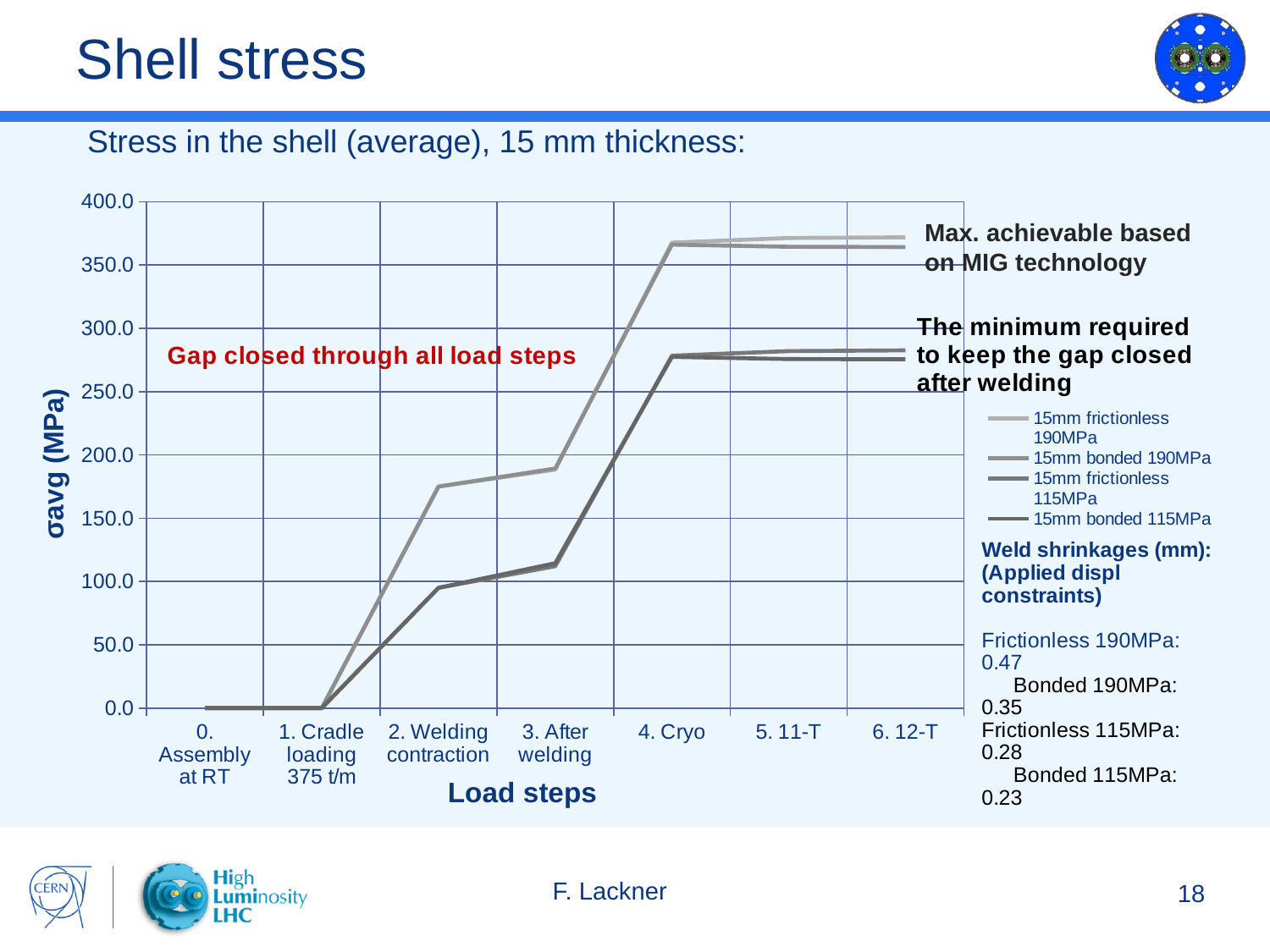
How many series does the legend list? 4 At "4. Cryo", which is larger: the 15mm bonded 190MPa series or the 15mm bonded 115MPa series? 15mm bonded 190MPa Do the series values generally rise or fall from "0. Assembly at RT" to "4. Cryo"? rise Is the value of the 15mm frictionless 190MPa series at "2. Welding contraction" greater or less than 150? greater What is the label of the y axis? σavg (MPa) How many load steps are shown on the x axis? 7 Is the value of the 15mm bonded 115MPa series at "2. Welding contraction" greater or less than 100? less What is the value of the 15mm frictionless 115MPa series at "1. Cradle loading 375 t/m"? 0.0 Is the value of the 15mm frictionless 190MPa series at "4. Cryo" greater or less than 350? greater What kind of chart is shown on the slide? line chart What is the value of the 15mm bonded 190MPa series at "0. Assembly at RT"? 0.0